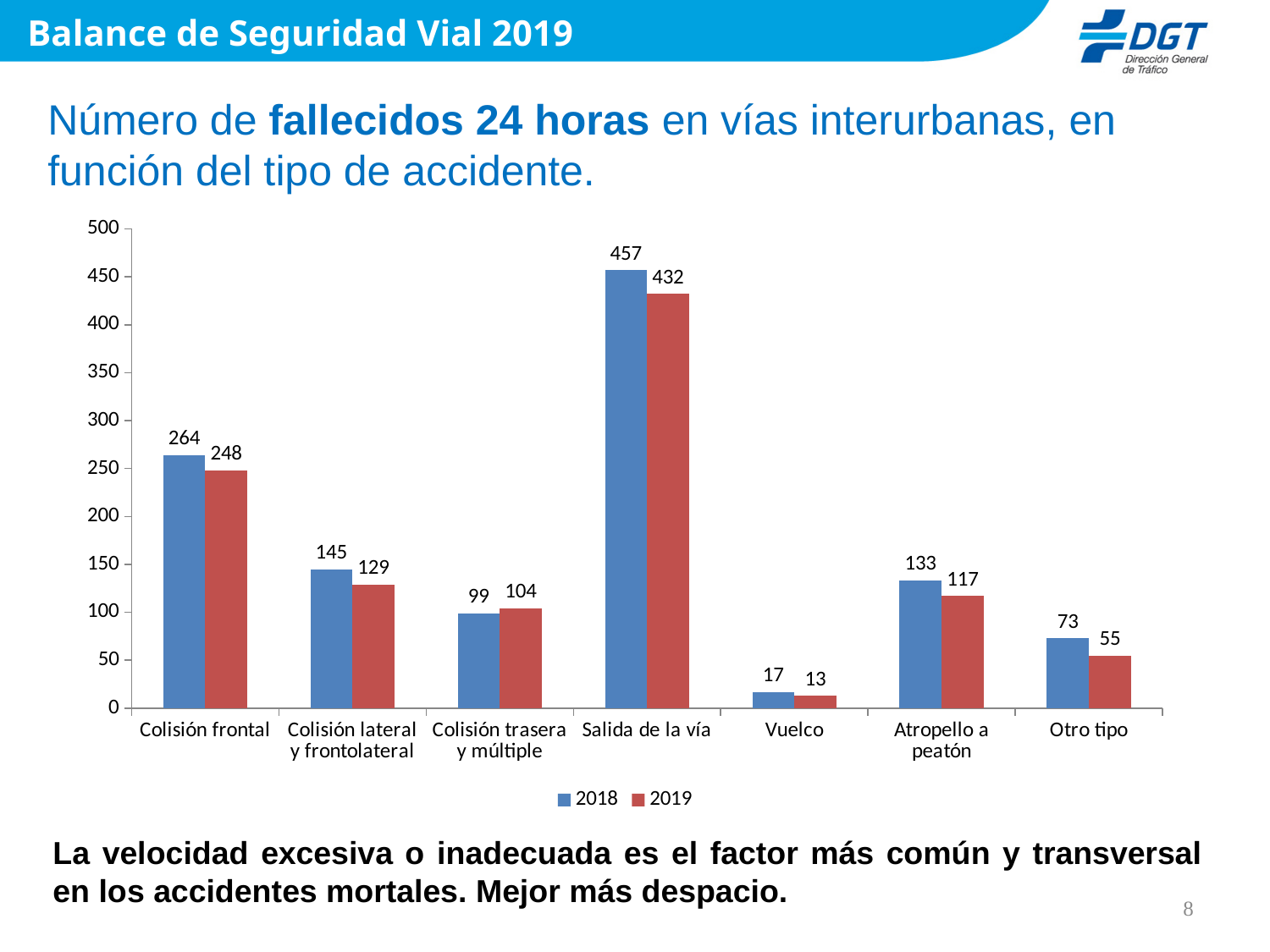
Which colour represents the 2019 series in the chart? red What is the difference between the 2018 and 2019 values for Colisión frontal? 16 Is the 2018 value for Otro tipo greater or less than 100? less Which accident type has the highest number of fatalities in 2018? Salida de la vía How many series does the legend list? 2 What kind of chart is shown on the slide? bar chart Which accident type has the lowest number of fatalities in 2019? Vuelco Which is larger for Colisión trasera y múltiple, the 2018 value or the 2019 value? 2019 What is the value for Colisión frontal in 2018? 264 How many accident type categories are shown on the x axis? 7 What is the value for Atropello a peatón in 2019? 117 What is the value for Salida de la vía in 2019? 432